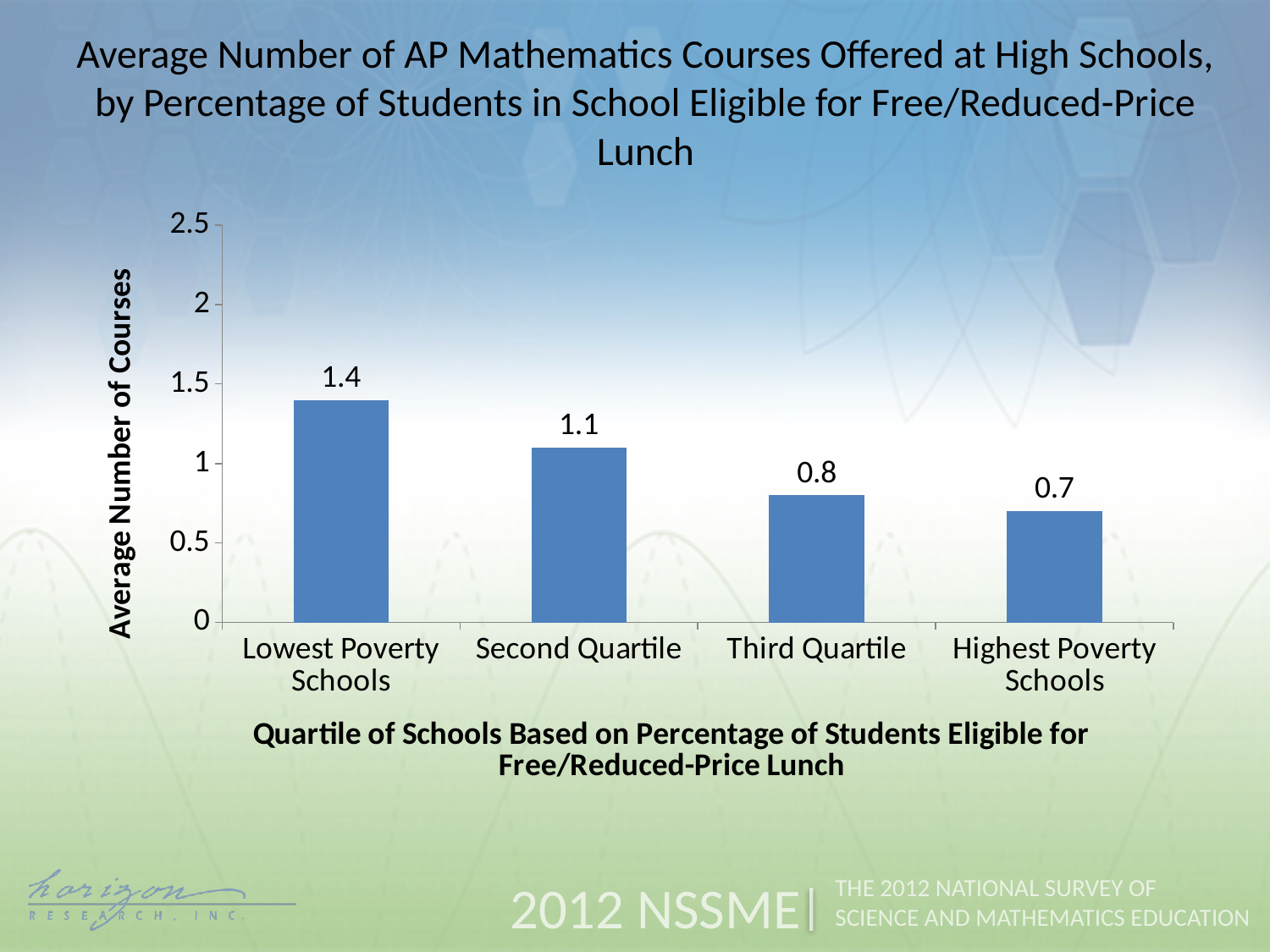
What is the average number of AP mathematics courses offered at Third Quartile schools? 0.8 Which quartile has the highest average number of AP mathematics courses? Lowest Poverty Schools What is the difference in average number of AP mathematics courses between Lowest Poverty Schools and Highest Poverty Schools? 0.7 Which quartile has the lowest average number of AP mathematics courses? Highest Poverty Schools What is the average number of AP mathematics courses offered at Second Quartile schools? 1.1 What kind of chart is shown on the slide? Bar chart Do the values rise or fall moving from Lowest Poverty Schools to Highest Poverty Schools along the x axis? Fall Which has a higher average number of AP mathematics courses, Second Quartile or Third Quartile schools? Second Quartile How many quartile categories are shown on the x axis? 4 What is the average number of AP mathematics courses offered at Highest Poverty Schools? 0.7 Is the value for Lowest Poverty Schools greater or less than 1? greater What is the average number of AP mathematics courses offered at Lowest Poverty Schools? 1.4